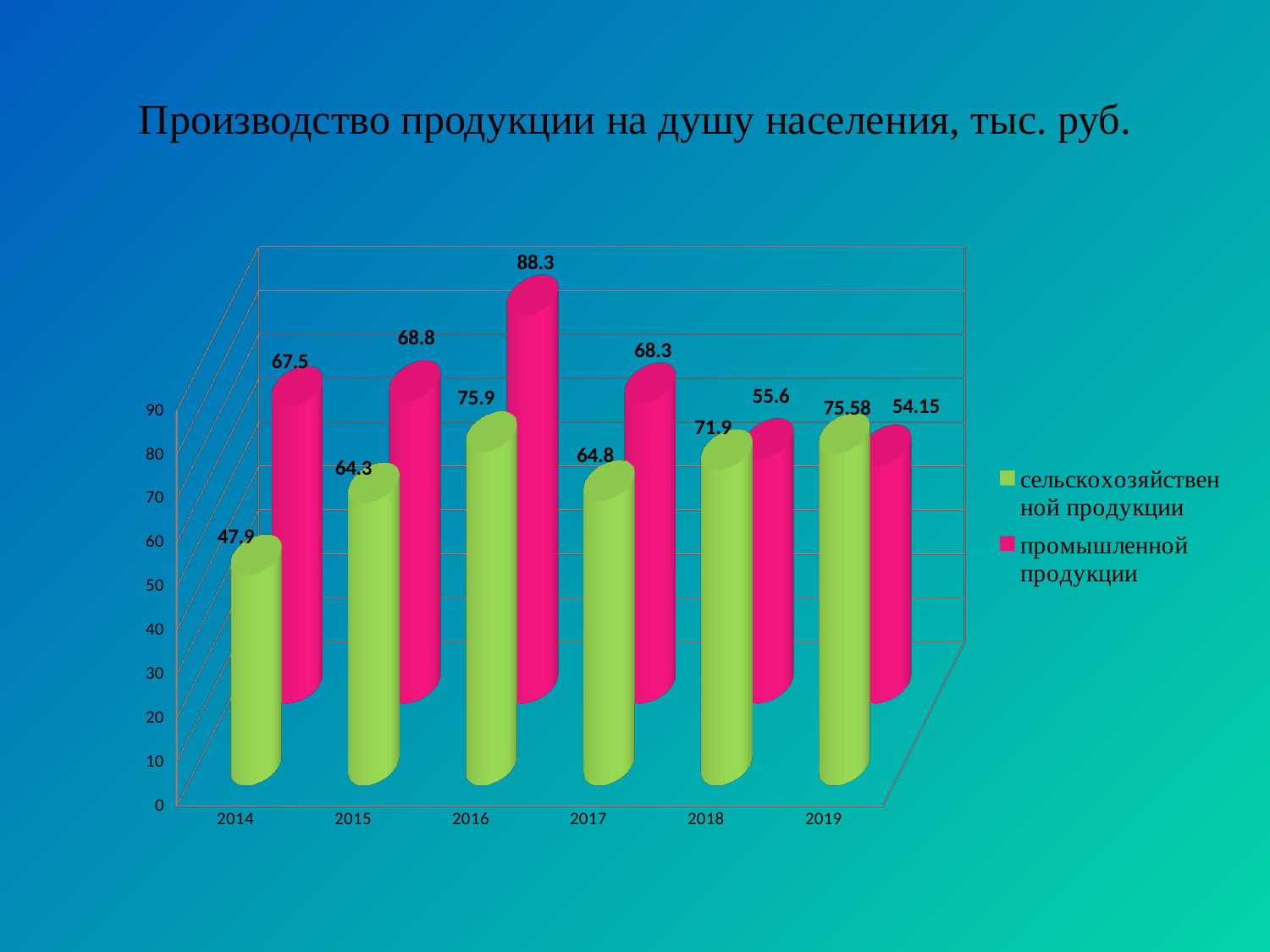
What is the value for сельскохозяйственной продукции in 2014? 47.9 What is the value for сельскохозяйственной продукции in 2018? 71.9 How many series does the legend list? 2 What is the value for промышленной продукции in 2016? 88.3 What is the title of the chart? Производство продукции на душу населения, тыс. руб. How many years are shown on the x axis? 6 In which year is промышленной продукции highest? 2016 What kind of chart is this? bar chart What is the value for промышленной продукции in 2019? 54.15 Which is larger in 2018: сельскохозяйственной продукции or промышленной продукции? сельскохозяйственной продукции In which year is сельскохозяйственной продукции lowest? 2014 What is the difference between промышленной продукции and сельскохозяйственной продукции in 2014? 19.6